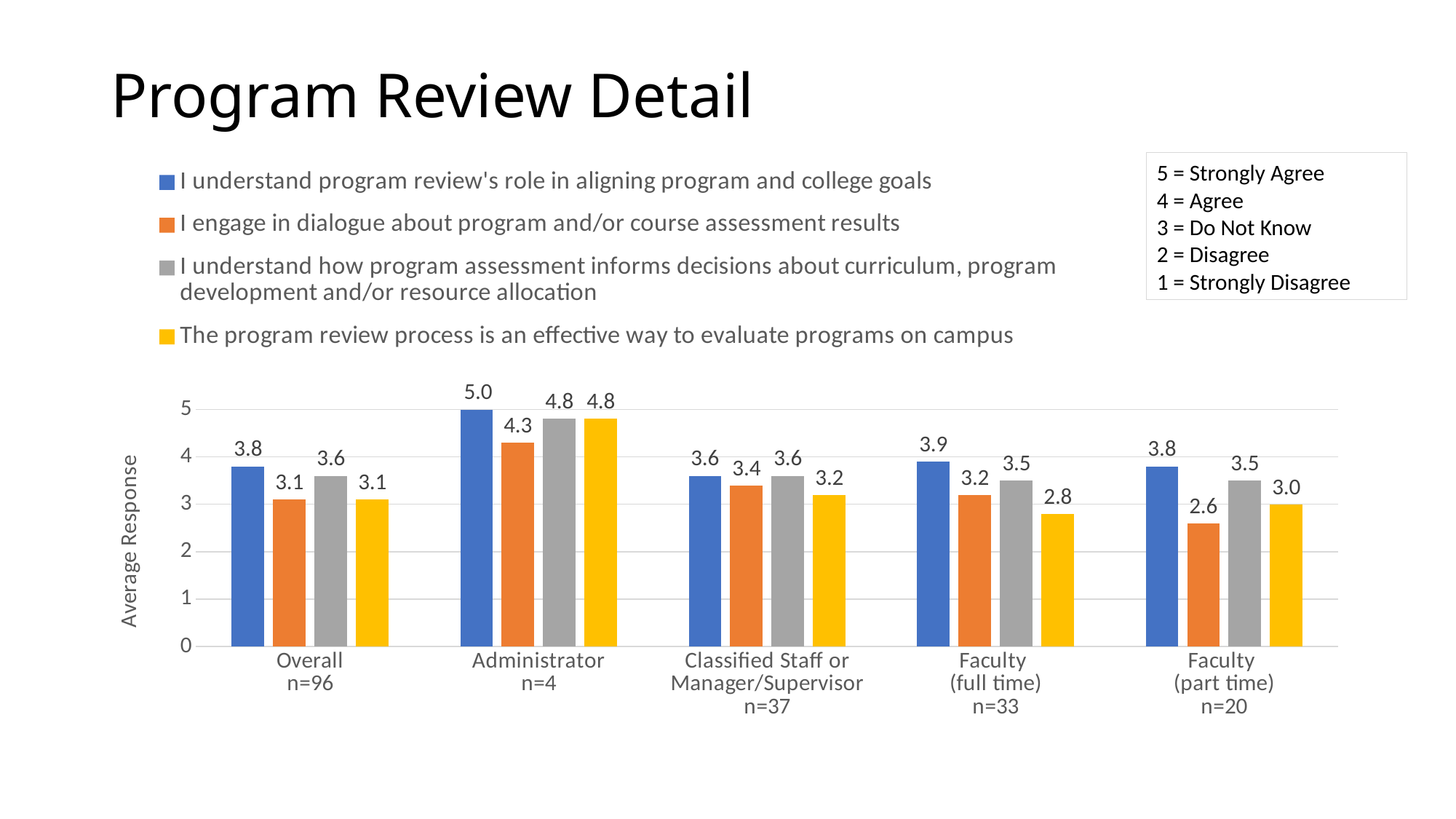
Which respondent group has the highest average response for 'I understand how program assessment informs decisions about curriculum, program development and/or resource allocation'? Administrator What is the label of the vertical axis? Average Response What is the average response for Faculty (part time) on 'I engage in dialogue about program and/or course assessment results'? 2.6 Which respondent group has the lowest average response for 'The program review process is an effective way to evaluate programs on campus'? Faculty (full time) How many respondents are in the Classified Staff or Manager/Supervisor group? 37 How many series does the legend list? 4 What is the average response for Administrators on 'I understand program review's role in aligning program and college goals'? 5.0 What kind of chart is shown on the slide? Bar chart How many respondent groups are shown on the x axis? 5 For Faculty (full time), which is larger: the average response for 'I understand program review's role in aligning program and college goals' or for 'The program review process is an effective way to evaluate programs on campus'? I understand program review's role in aligning program and college goals What is the Overall average response for 'The program review process is an effective way to evaluate programs on campus'? 3.1 What is the difference between the Administrator and Overall average responses for 'I engage in dialogue about program and/or course assessment results'? 1.2